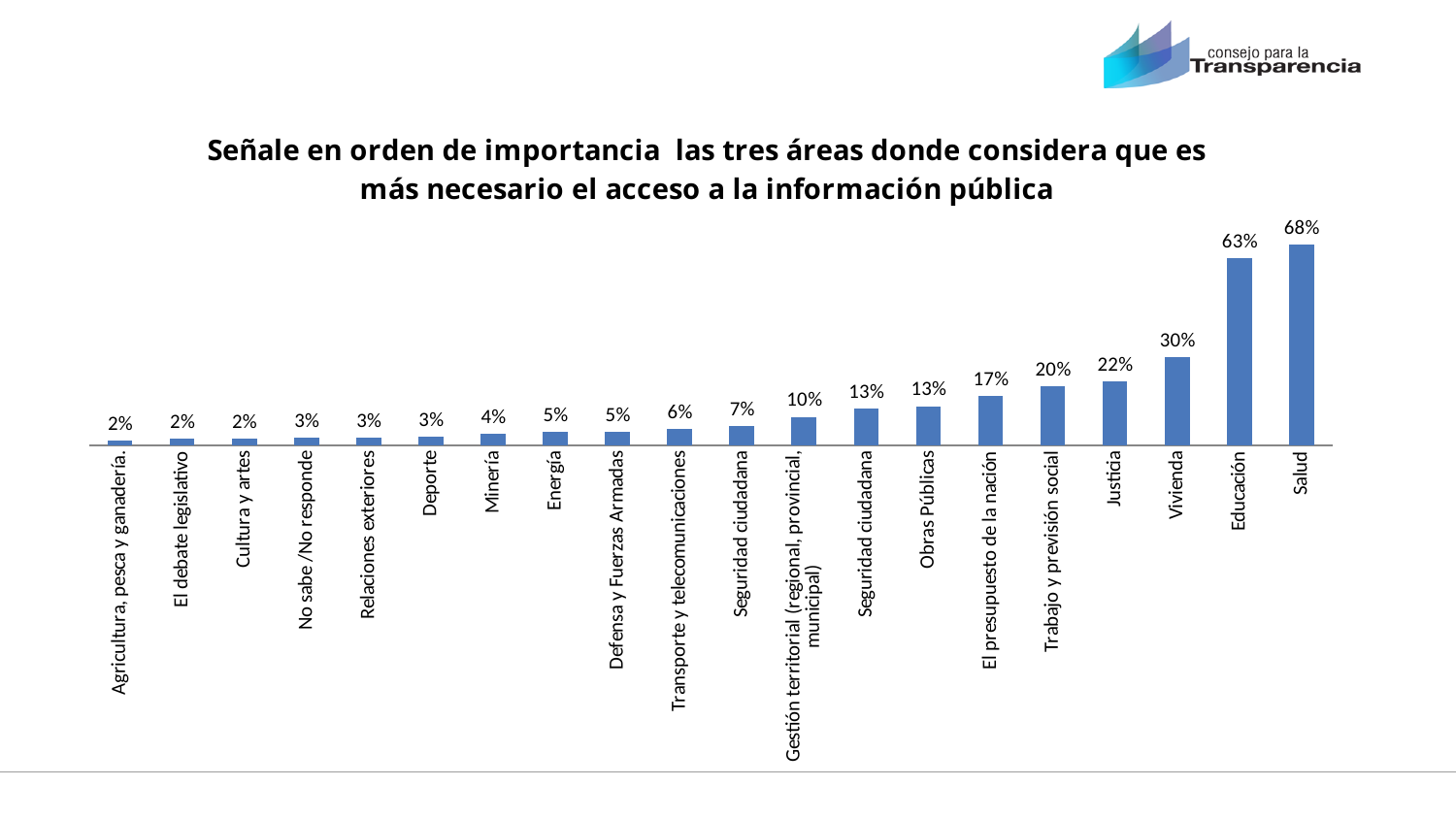
What is the value for Justicia? 22% Which category has the highest value? Salud What is the difference between the values for Salud and Educación? 5 percentage points What kind of chart is shown on the slide? Bar chart Which is larger, the value for Vivienda or the value for Trabajo y previsión social? Vivienda What is the value for Minería? 4% How many categories are shown in the chart? 20 What is the difference between the values for Vivienda and Justicia? 8 percentage points What is the value for Obras Públicas? 13% What is the value for Vivienda? 30% What is the value for Salud? 68% What is the value for Educación? 63%